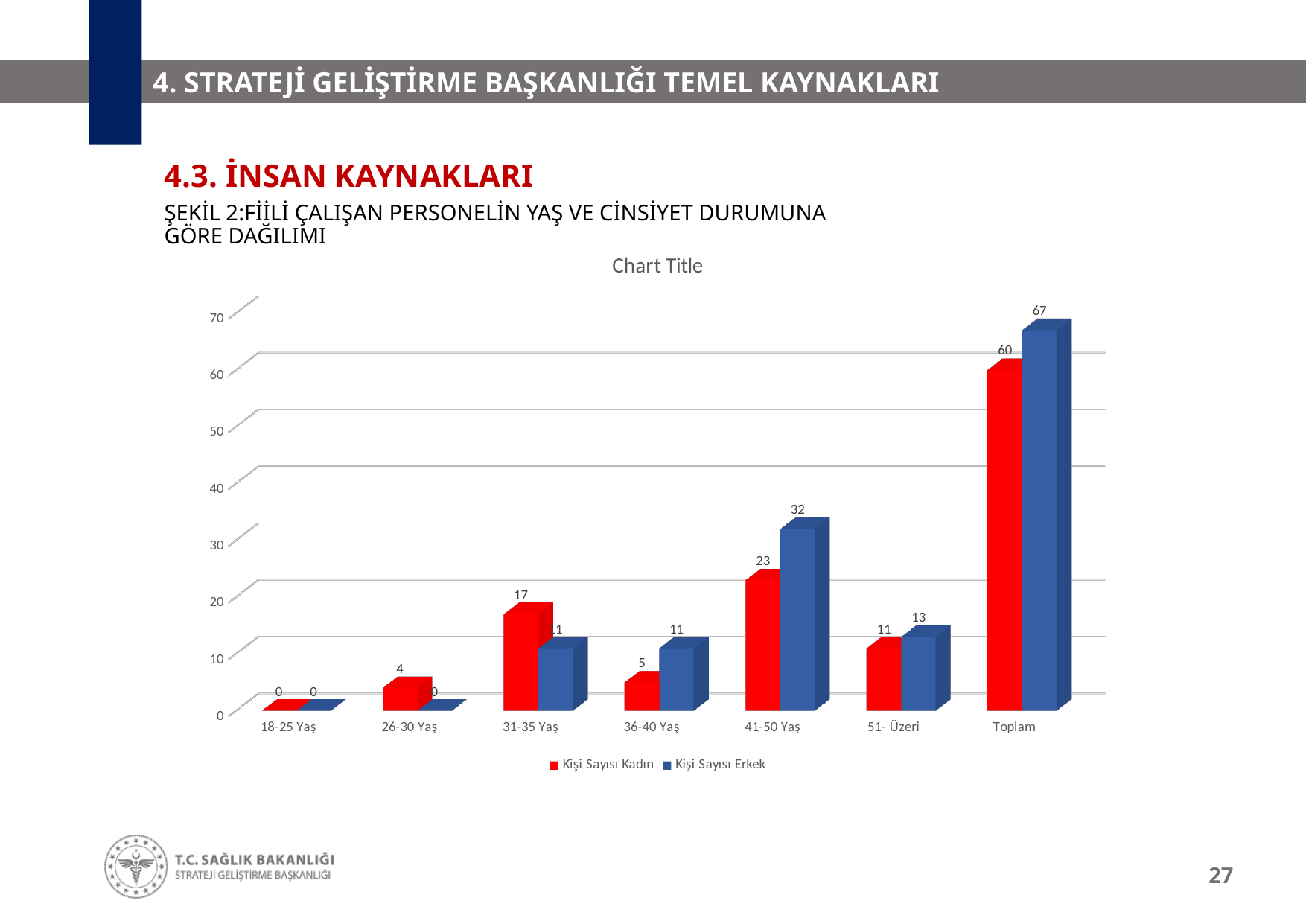
What is the value of Kişi Sayısı Erkek for 41-50 Yaş? 32 What is the difference between Kişi Sayısı Erkek and Kişi Sayısı Kadın for Toplam? 7 What is the value of Kişi Sayısı Kadın for 31-35 Yaş? 17 What is the value of Kişi Sayısı Kadın for 41-50 Yaş? 23 What kind of chart is shown on the slide? bar chart For 41-50 Yaş, which series is larger, Kişi Sayısı Kadın or Kişi Sayısı Erkek? Kişi Sayısı Erkek Excluding Toplam, which age group has the highest value for Kişi Sayısı Kadın? 41-50 Yaş What is the value of Kişi Sayısı Erkek for 51- Üzeri? 13 How many categories are shown on the x axis? 7 What is the value of Kişi Sayısı Erkek for Toplam? 67 What is the value of Kişi Sayısı Kadın for Toplam? 60 How many series does the legend list? 2